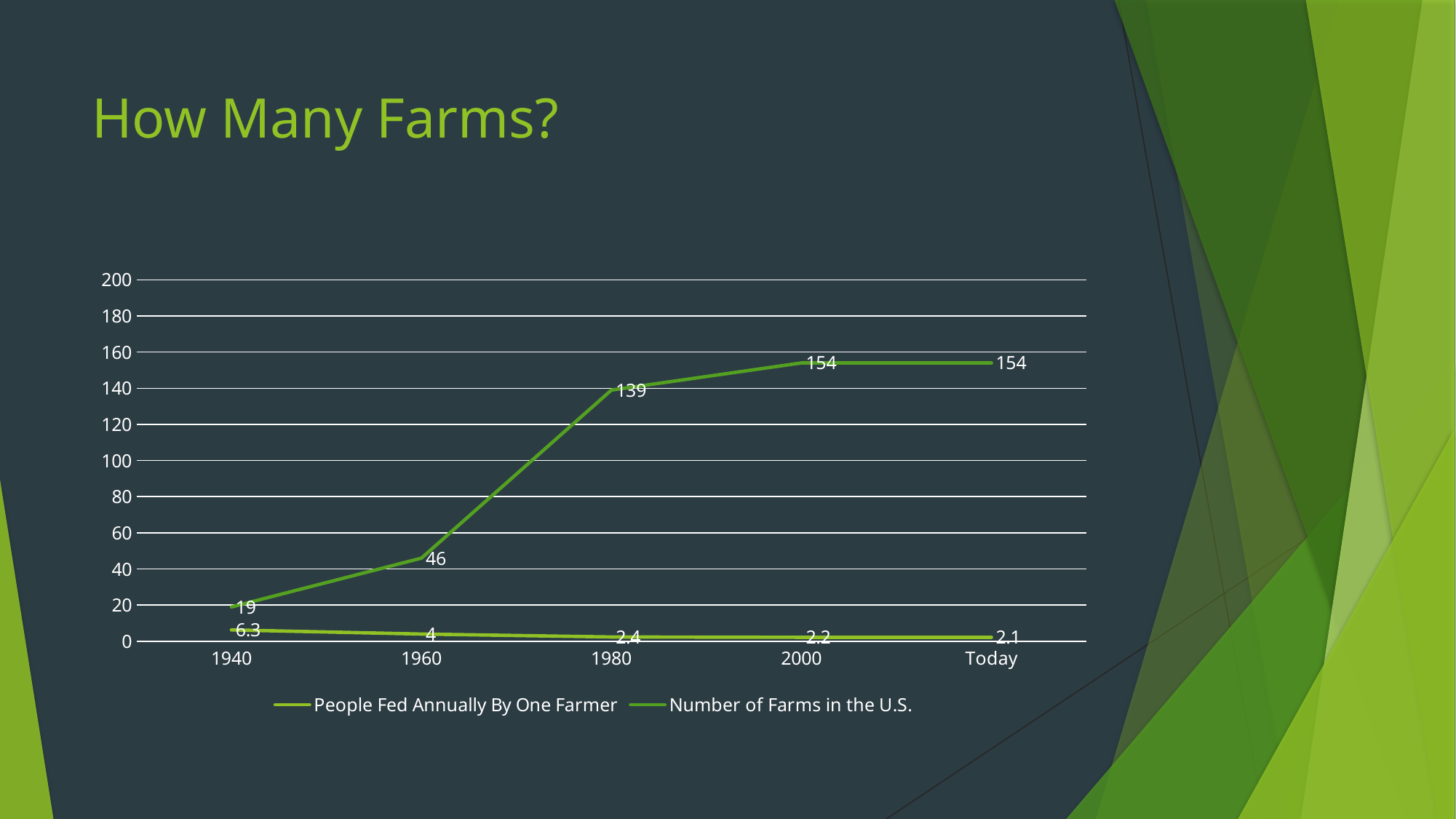
How many series does the legend list? 2 How many points along the x axis does each line have? 5 What is the difference between the upper line's values at 1980 and 1960? 93 What is the value labelled on the upper line at 1980? 139 Is the upper line's value at 1960 greater or less than 40? greater At which x-axis category is the upper line at its lowest value? 1940 What is the value labelled on the lower line at 1940? 6.3 What is the value labelled on the upper line at 1940? 19 What is the value labelled on the lower line for Today? 2.1 What is the title of the slide? How Many Farms? Does the lower line rise or fall from 1940 to Today? fall What type of chart is shown on the slide? line chart